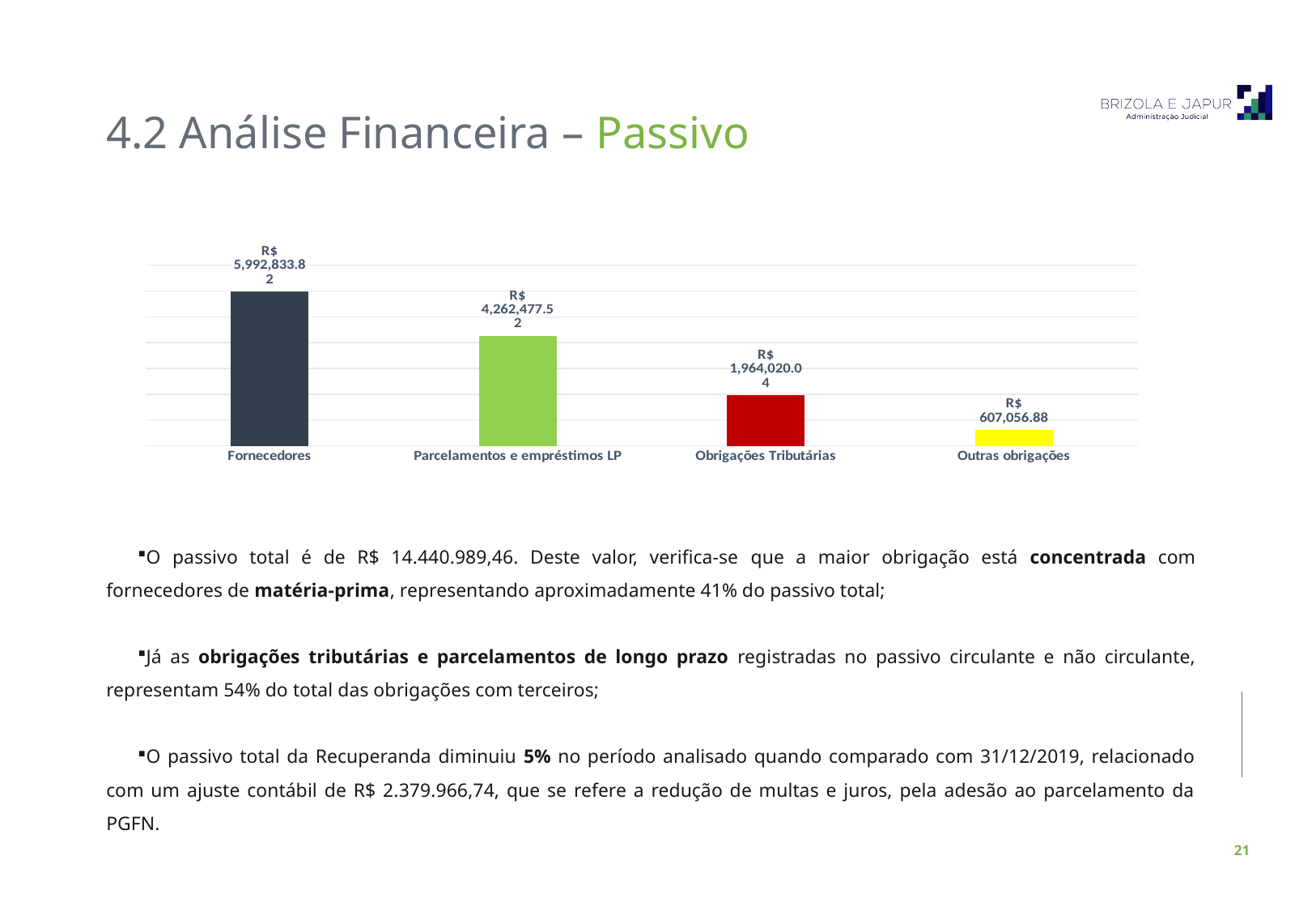
What is the value for Parcelamentos e empréstimos LP? R$ 4,262,477.52 What is the value for Fornecedores? R$ 5,992,833.82 Do the values rise or fall from left to right along the x axis? Fall What is the difference between the values for Obrigações Tributárias and Outras obrigações? R$ 1,356,963.16 What is the value for Outras obrigações? R$ 607,056.88 What is the difference between the values for Fornecedores and Parcelamentos e empréstimos LP? R$ 1,730,356.30 Which is larger, the value for Parcelamentos e empréstimos LP or the value for Obrigações Tributárias? Parcelamentos e empréstimos LP What kind of chart is shown on the slide? Bar chart Which category has the highest value? Fornecedores What is the value for Obrigações Tributárias? R$ 1,964,020.04 Which category has the lowest value? Outras obrigações How many categories are shown in the chart? 4